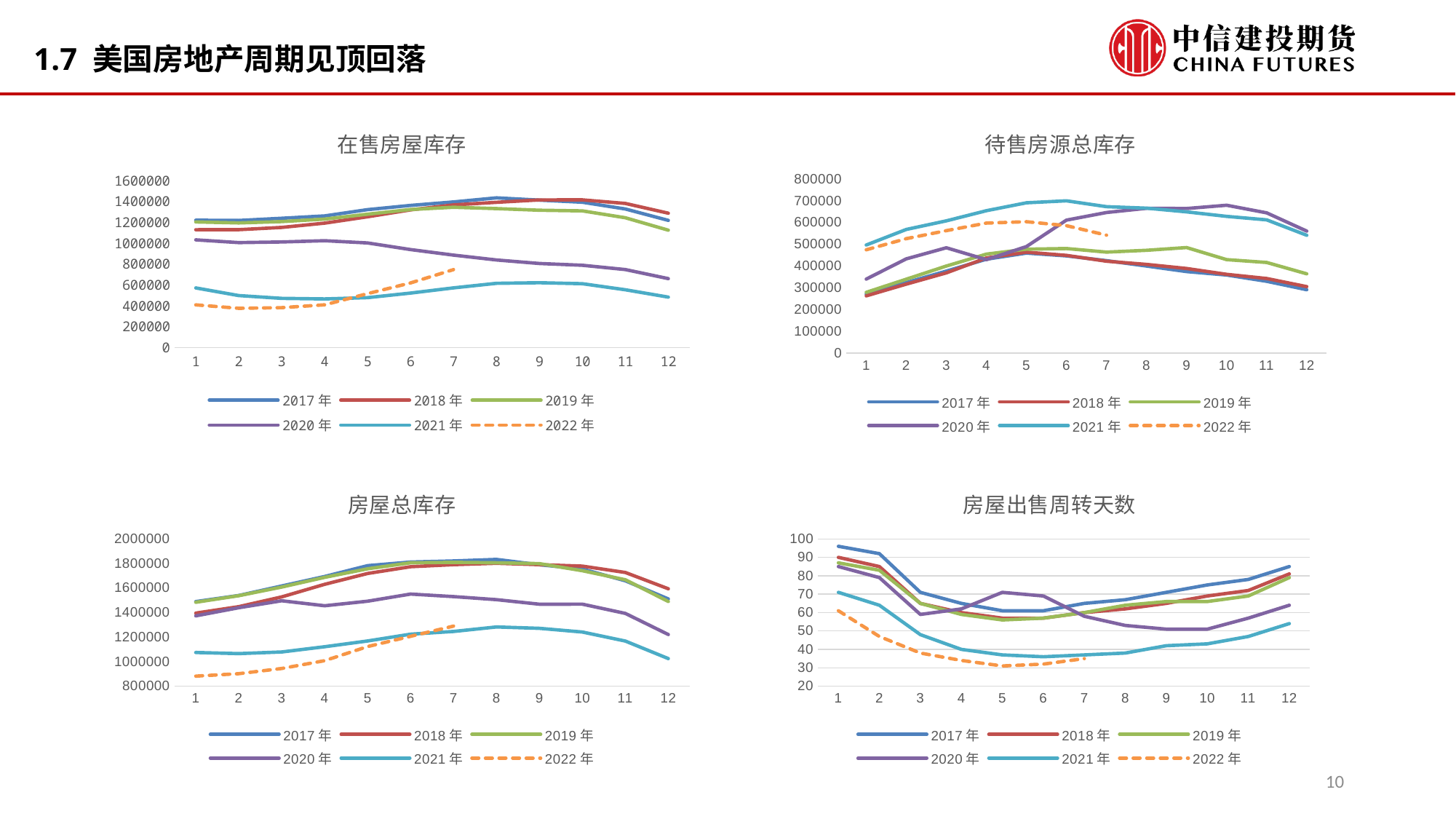
In the 在售房屋库存 chart, which series is drawn as a dashed line? 2022年 In the 待售房源总库存 chart, is the value for 2018年 at month 1 greater or less than 300000? less How many series does the legend of the 待售房源总库存 chart list? 6 In the 房屋出售周转天数 chart, which series has the highest value at month 1? 2017年 In the 房屋出售周转天数 chart, does the 2021年 line rise or fall from month 1 to month 5? fall In the 在售房屋库存 chart, is the value for 2022年 at month 1 greater or less than 600000? less What kind of chart is the 在售房屋库存 chart? line chart In the 待售房源总库存 chart, is the value for 2020年 at month 10 greater or less than 600000? greater How many points are on the x axis of the 房屋总库存 chart? 12